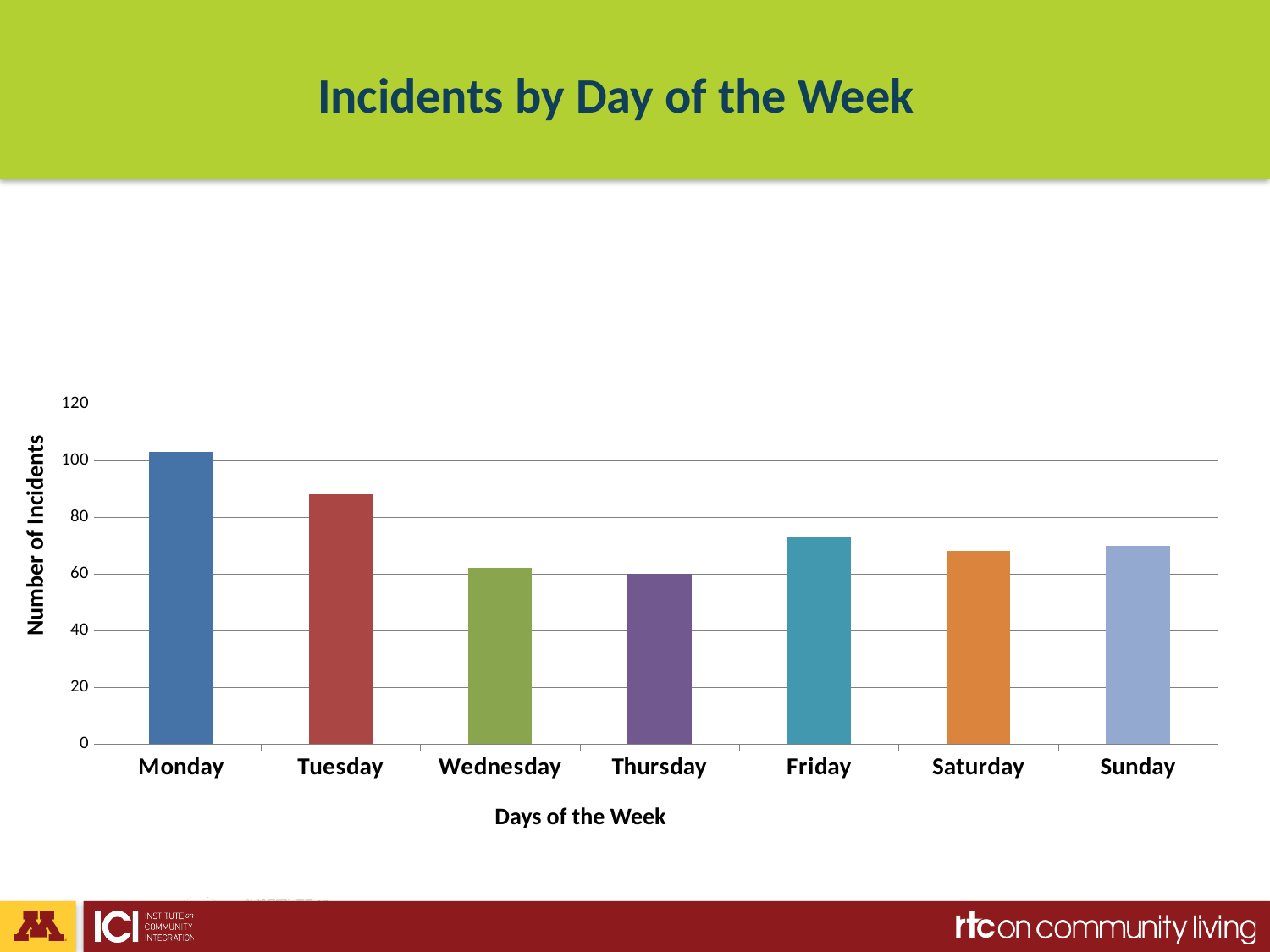
What kind of chart is shown on the slide? bar chart Is the value for Saturday greater or less than 60? greater Which day has the highest number of incidents? Monday Which has more incidents, Friday or Wednesday? Friday Is the value for Friday greater or less than 80? less What is the title of the chart? Incidents by Day of the Week Which has more incidents, Monday or Tuesday? Monday Is the value for Wednesday greater or less than 80? less What is the label of the vertical axis? Number of Incidents How many days are plotted on the x axis? 7